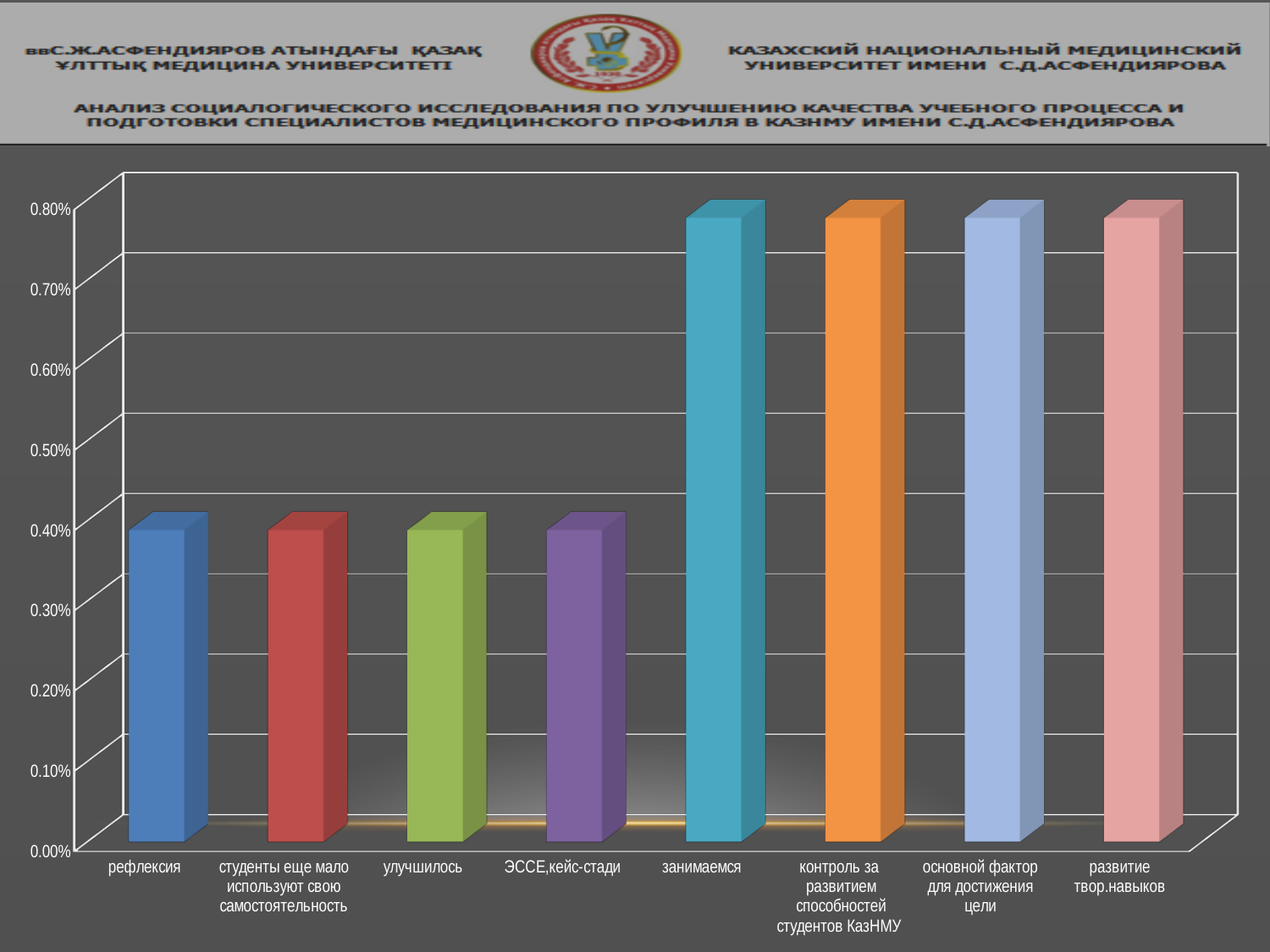
Which is larger, the value for улучшилось or the value for контроль за развитием способностей студентов КазНМУ? контроль за развитием способностей студентов КазНМУ Is the value for основной фактор для достижения цели greater or less than 0.50%? greater Is the value for ЭССЕ,кейс-стади greater or less than 0.30%? greater Which is larger, the value for занимаемся or the value for рефлексия? занимаемся Is the value for рефлексия greater or less than 0.60%? less What is the highest tick value shown on the y axis of the chart? 0.80% What kind of chart is shown on the slide? bar chart How many categories are shown on the x axis of the chart? 8 What colour is the bar for рефлексия? blue